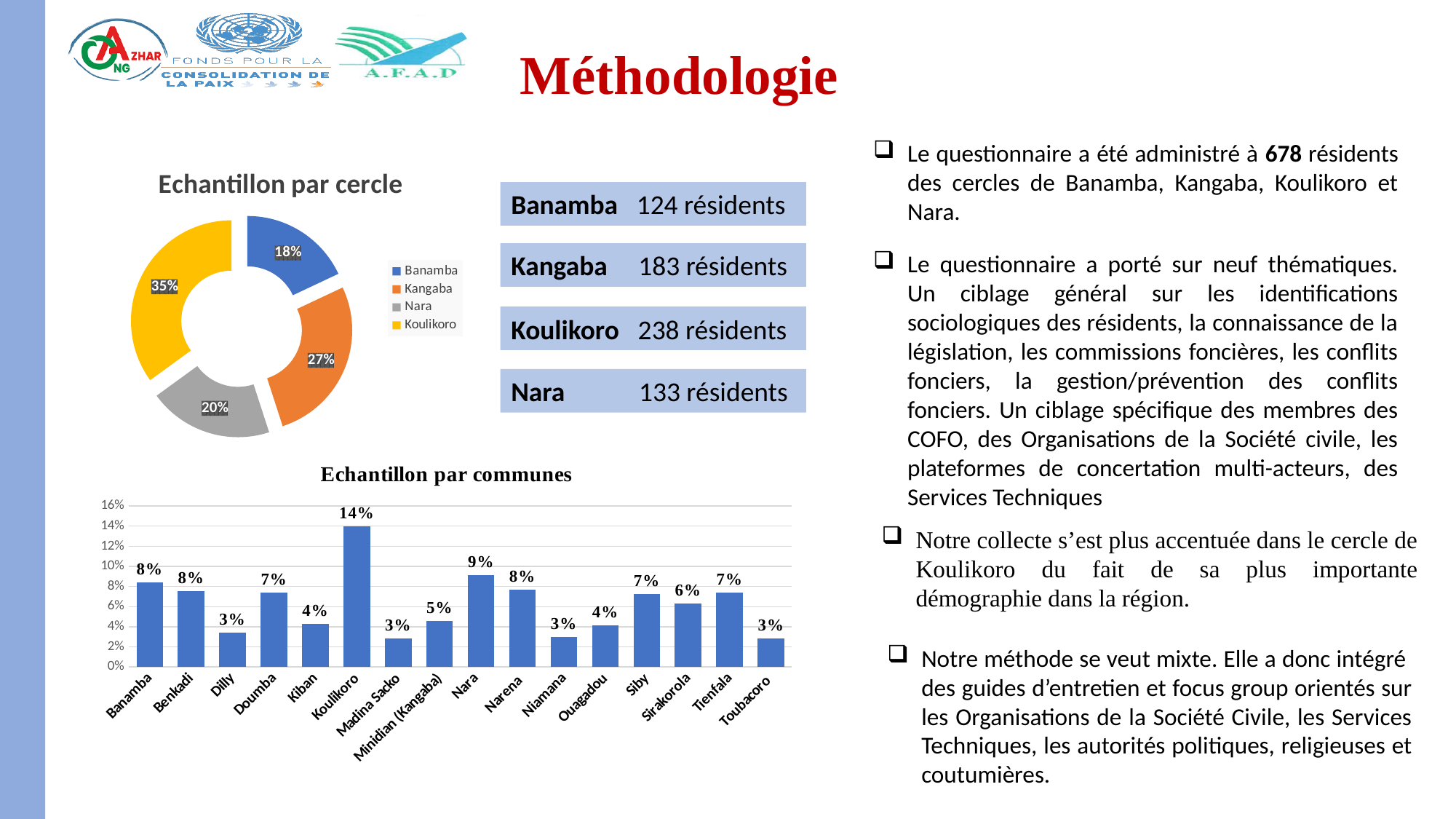
In the 'Echantillon par cercle' chart, what is the difference in percentage points between Koulikoro and Kangaba? 8 percentage points In the 'Echantillon par cercle' chart, which cercle has the largest share? Koulikoro What kind of chart is 'Echantillon par cercle'? Doughnut chart In the 'Echantillon par cercle' chart, what share does Koulikoro have? 35% In the 'Echantillon par cercle' chart, which cercle has the smallest share? Banamba In the 'Echantillon par communes' chart, which is larger, Sirakorola or Kiban? Sirakorola In the 'Echantillon par communes' chart, how many communes are shown on the x axis? 16 In the 'Echantillon par communes' chart, what is the value for Koulikoro? 14% In the 'Echantillon par communes' chart, what is the value for Nara? 9% In the 'Echantillon par cercle' chart, how many cercles does the legend list? 4 In the 'Echantillon par communes' chart, which commune has the highest value? Koulikoro What kind of chart is 'Echantillon par communes'? Bar chart